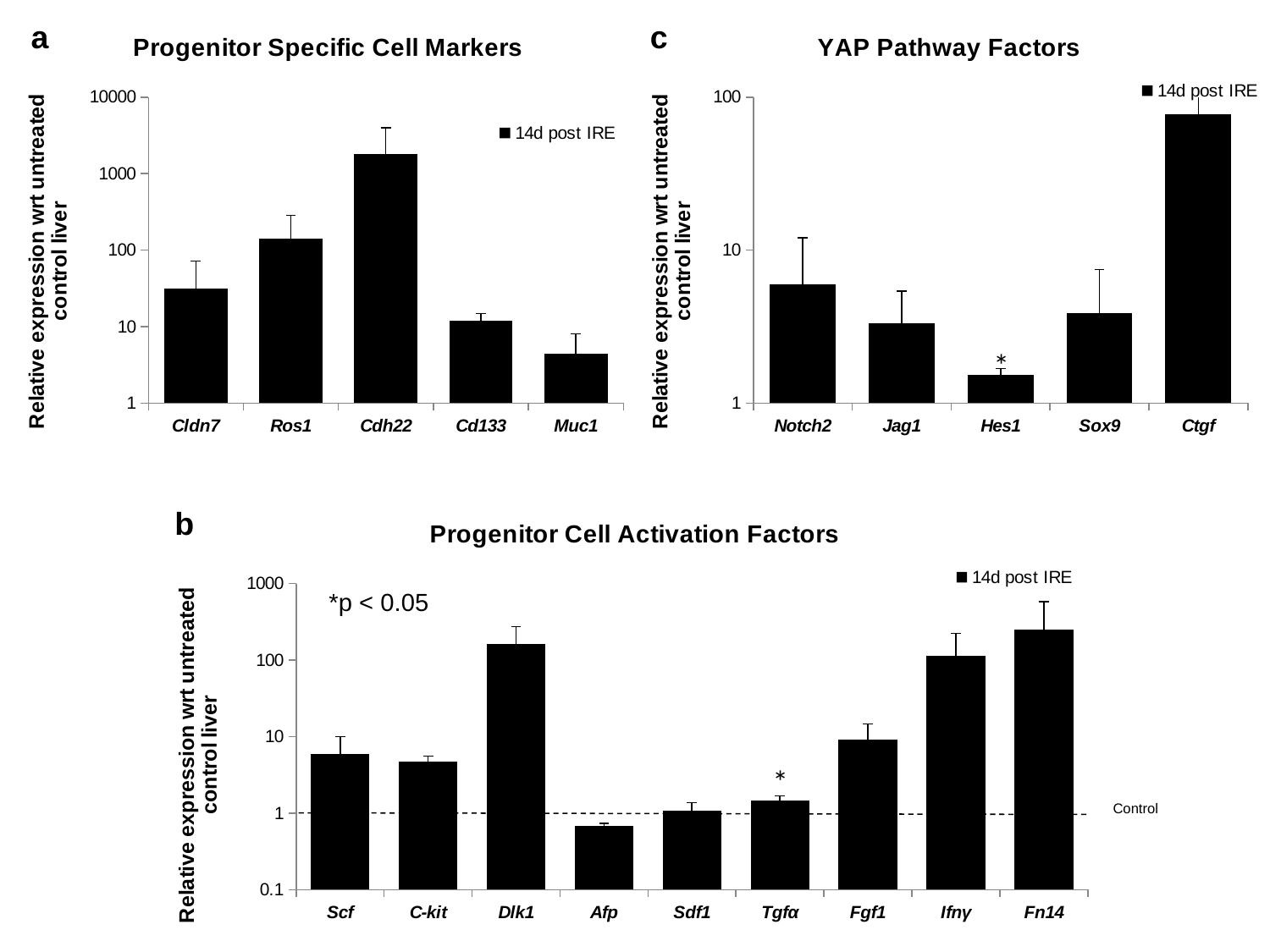
In the 'Progenitor Cell Activation Factors' chart, is the value for Dlk1 greater or less than 100? greater In the 'YAP Pathway Factors' chart, which gene has the lowest relative expression? Hes1 In the 'Progenitor Specific Cell Markers' chart, which gene has the lowest relative expression? Muc1 How many genes are plotted in the 'Progenitor Specific Cell Markers' chart? 5 In the 'Progenitor Specific Cell Markers' chart, is the value for Cdh22 greater or less than 1000? greater In the 'Progenitor Cell Activation Factors' chart, which is larger, the value for Ifnγ or the value for Fgf1? Ifnγ In the 'Progenitor Cell Activation Factors' chart, which gene has the lowest relative expression? Afp In the 'YAP Pathway Factors' chart, which gene has the highest relative expression? Ctgf In the 'Progenitor Specific Cell Markers' chart, which gene has the highest relative expression? Cdh22 How many genes are plotted in the 'Progenitor Cell Activation Factors' chart? 9 What type of chart is the 'YAP Pathway Factors' chart? bar chart In the 'YAP Pathway Factors' chart, is the value for Ctgf greater or less than 10? greater